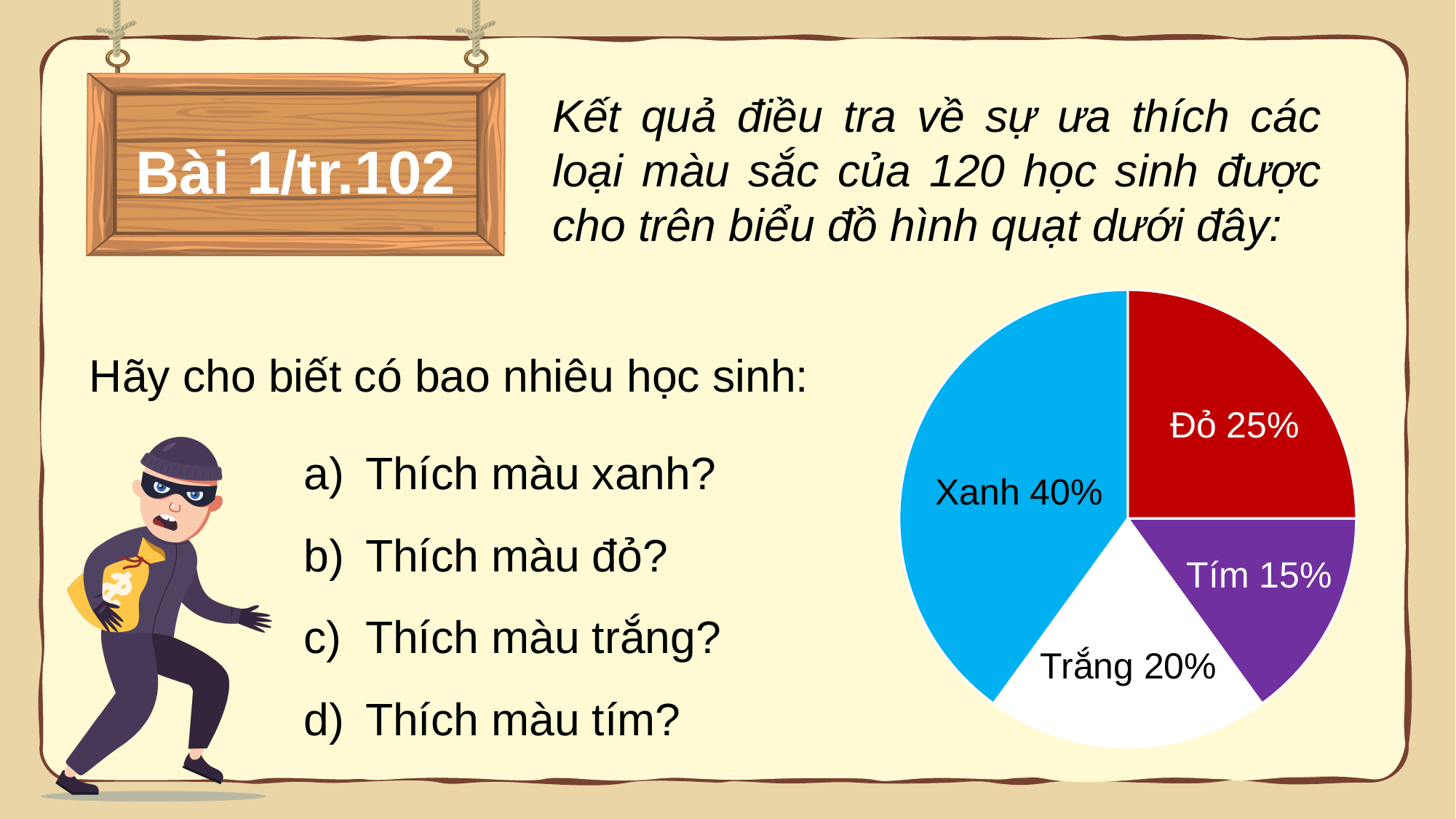
What percentage of the pie chart is labelled Trắng? 20% What percentage of the pie chart is labelled Xanh? 40% What is the difference in percentage points between the Xanh slice and the Đỏ slice? 15% What colour is the slice labelled Tím 15% in the pie chart? Purple What percentage of the pie chart is labelled Tím? 15% What percentage of the pie chart is labelled Đỏ? 25% How many slices does the pie chart have? 4 Which colour category has the largest slice of the pie chart? Xanh What is the difference in percentage points between the Trắng slice and the Tím slice? 5% What kind of chart is shown on the slide? Pie chart Which colour category has the smallest slice of the pie chart? Tím Which slice is larger, Đỏ or Trắng? Đỏ